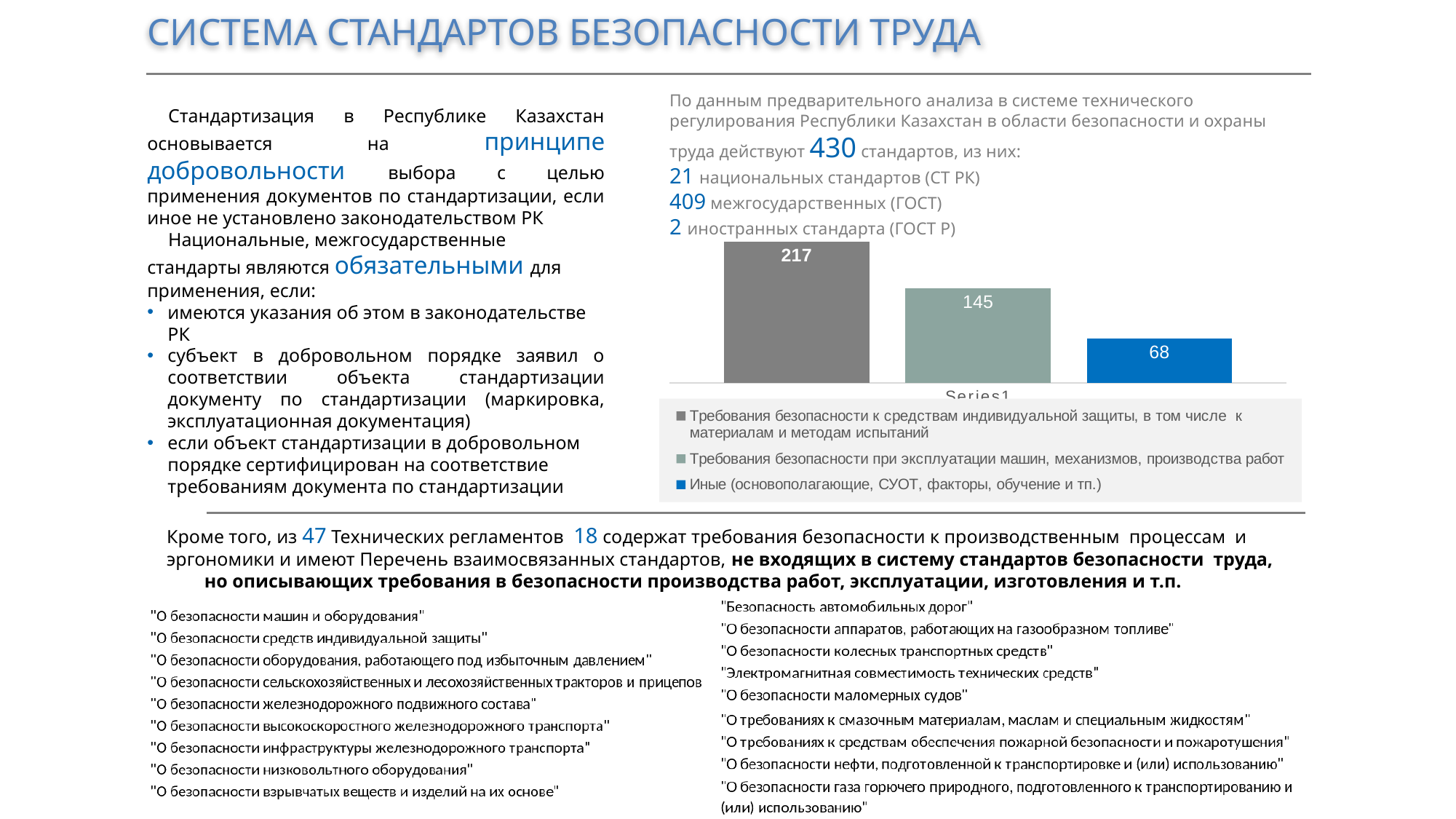
Which legend category has the lowest value in the chart? Иные (основополагающие, СУОТ, факторы, обучение и тп.) What is the value of the bar for "Требования безопасности при эксплуатации машин, механизмов, производства работ"? 145 What is the difference between the values 217 and 145 shown in the chart? 72 Which is larger: the value for "Требования безопасности при эксплуатации машин, механизмов, производства работ" or the value for "Иные (основополагающие, СУОТ, факторы, обучение и тп.)"? Требования безопасности при эксплуатации машин, механизмов, производства работ What type of chart is shown on the slide? bar chart What colour is the bar with the value 68? blue How many entries does the chart legend list? 3 Which legend category has the highest value in the chart? Требования безопасности к средствам индивидуальной защиты, в том числе к материалам и методам испытаний What is the difference between the values 145 and 68 shown in the chart? 77 What is the value of the bar for "Иные (основополагающие, СУОТ, факторы, обучение и тп.)"? 68 How many bars are plotted in the chart? 3 What is the value of the bar for "Требования безопасности к средствам индивидуальной защиты, в том числе к материалам и методам испытаний"? 217